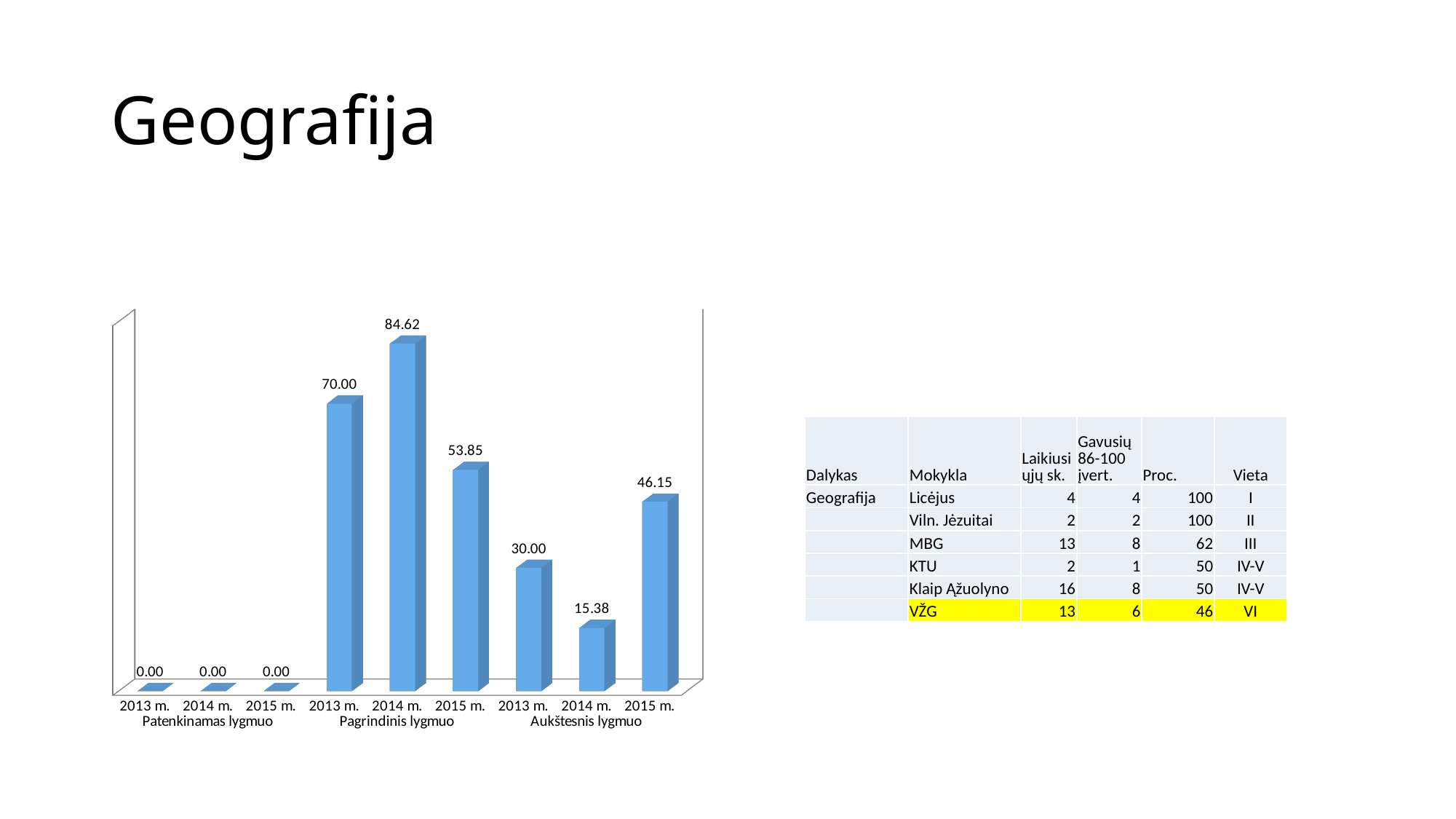
What kind of chart is shown on the slide? Bar chart Do the values in the Pagrindinis lygmuo group rise or fall from 2014 m. to 2015 m.? Fall What is the value for 2014 m. in the Pagrindinis lygmuo group? 84.62 How many level groups are shown along the x axis of the chart? 3 What is the value for 2015 m. in the Aukštesnis lygmuo group? 46.15 Within the Aukštesnis lygmuo group, which year has the lowest value? 2014 m. Which is larger: the 2013 m. value in Pagrindinis lygmuo or the 2013 m. value in Aukštesnis lygmuo? 2013 m. in Pagrindinis lygmuo What is the difference between the 2014 m. and 2015 m. values in the Pagrindinis lygmuo group? 30.77 What is the value for 2014 m. in the Aukštesnis lygmuo group? 15.38 What is the value for 2013 m. in the Patenkinamas lygmuo group? 0.00 How many bars are plotted on the chart? 9 Which bar has the highest value on the chart? 2014 m., Pagrindinis lygmuo